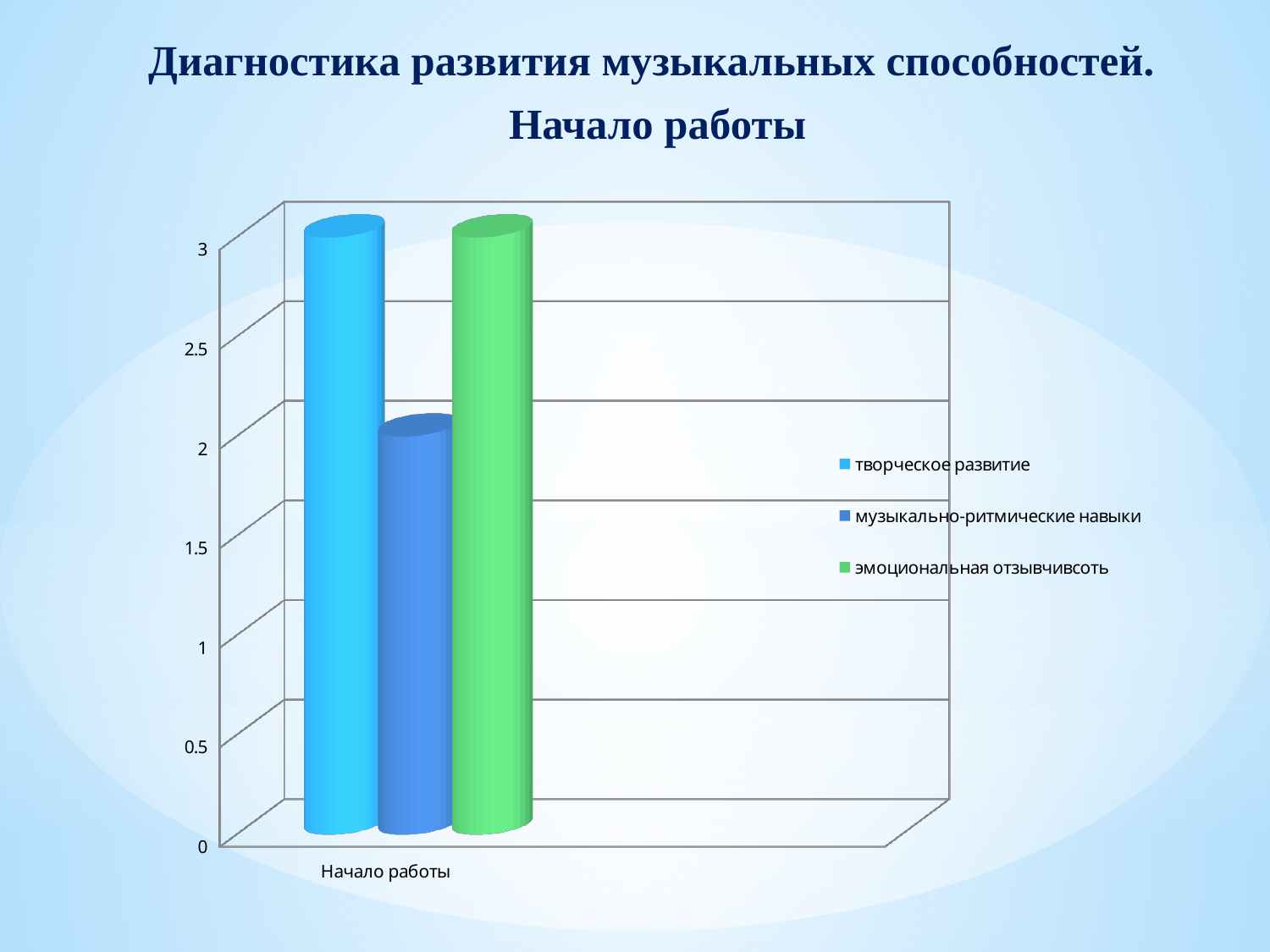
Which is larger for Начало работы: эмоциональная отзывчивсоть or музыкально-ритмические навыки? эмоциональная отзывчивсоть Is the value for музыкально-ритмические навыки greater or less than 2.5? less Which is larger for Начало работы: творческое развитие or музыкально-ритмические навыки? творческое развитие Which series has the lowest value for Начало работы? музыкально-ритмические навыки Is the value for эмоциональная отзывчивсоть greater or less than 2.5? greater What is the label of the single category on the x axis? Начало работы Is the value for музыкально-ритмические навыки greater or less than 1.5? greater How many categories are shown on the x axis? 1 What kind of chart is shown on the slide? bar chart Which series is shown in green in the legend? эмоциональная отзывчивсоть How many series does the legend list? 3